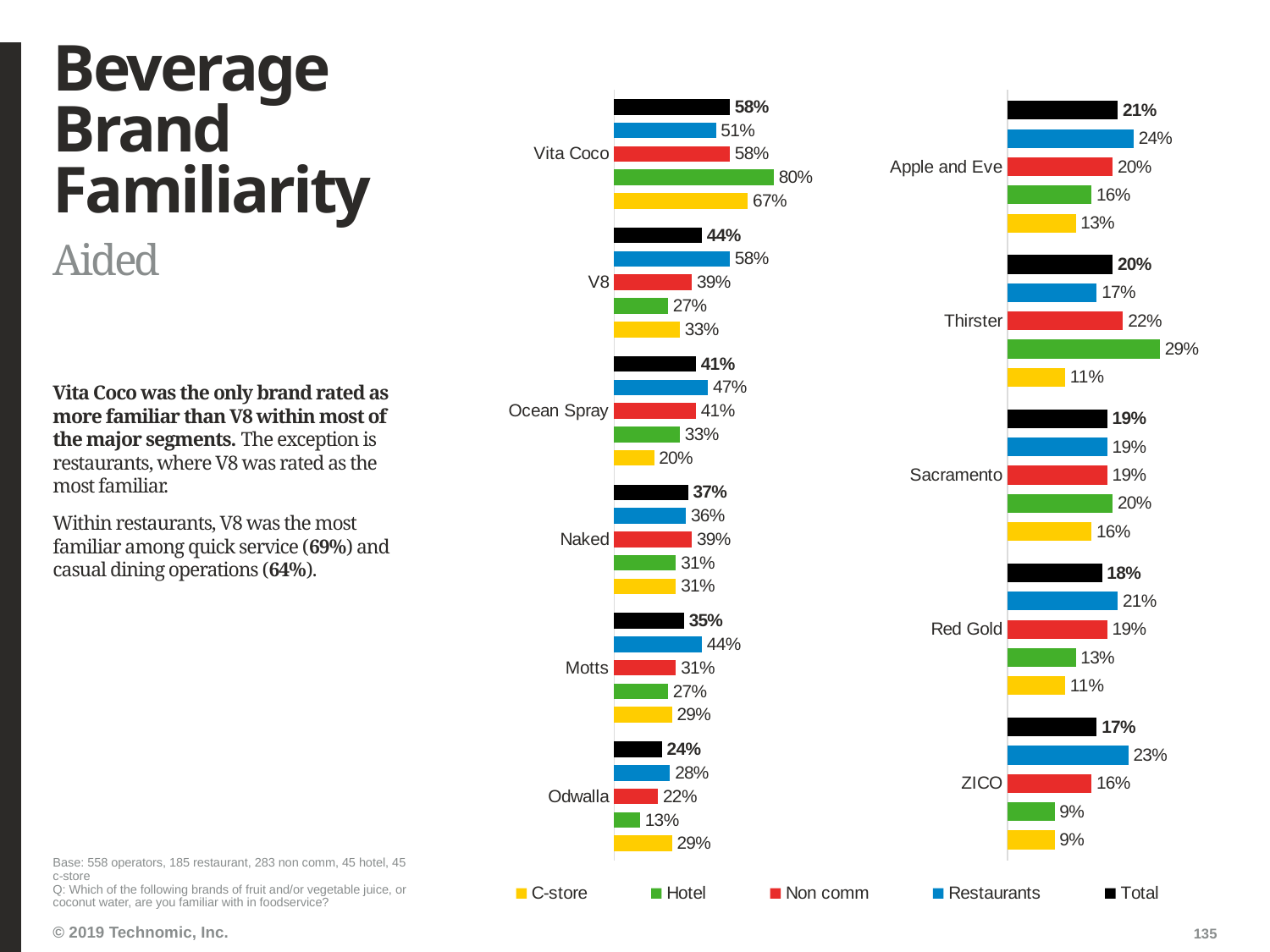
In the right chart, what is the Hotel value for Thirster? 29% In the left chart, what is the Hotel value for Vita Coco? 80% In the right chart, which is larger for Apple and Eve: the Restaurants value or the Hotel value? Restaurants In the left chart, what is the Restaurants value for V8? 58% Which colour represents the Non comm series in the legend? Red How many series does the legend list? 5 What type of chart is used on this slide? Bar chart In the right chart, which brand has the lowest C-store value? ZICO How many brands are shown in the left chart? 6 In the right chart, what is the Total value for ZICO? 17% In the left chart, what is the difference between the Hotel and C-store values for Vita Coco? 13% In the left chart, which brand has the highest Total value? Vita Coco